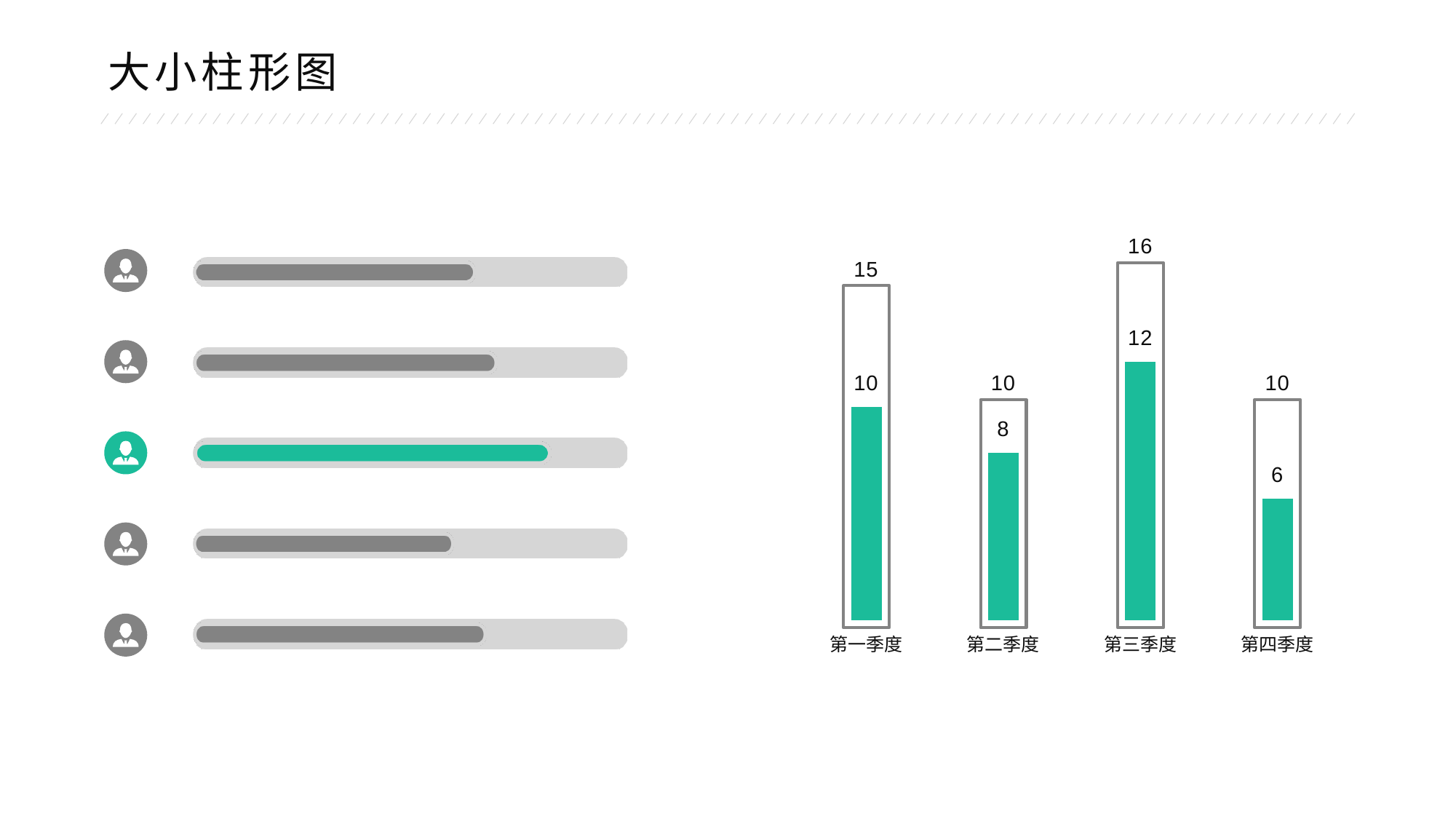
In the bar chart, what is the value of the inner green bar for 第四季度? 6 What kind of chart is shown on the right side of the slide? Bar chart In the bar chart, what is the difference between the inner green bar values of 第三季度 and 第二季度? 4 In the bar chart, which is larger: the inner green bar for 第二季度 or the inner green bar for 第四季度? 第二季度 How many quarters (categories) are shown in the bar chart? 4 In the bar chart, which quarter has the lowest inner green bar value? 第四季度 In the bar chart, what is the value of the outer outlined bar for 第二季度? 10 In the bar chart, which quarter has the highest inner green bar value? 第三季度 In the bar chart, what is the difference between the outer bar value and the inner green bar value for 第一季度? 5 In the bar chart, what is the value of the outer outlined bar for 第三季度? 16 What is the title of the slide containing the bar chart? 大小柱形图 In the bar chart, what is the value of the inner green bar for 第一季度? 10